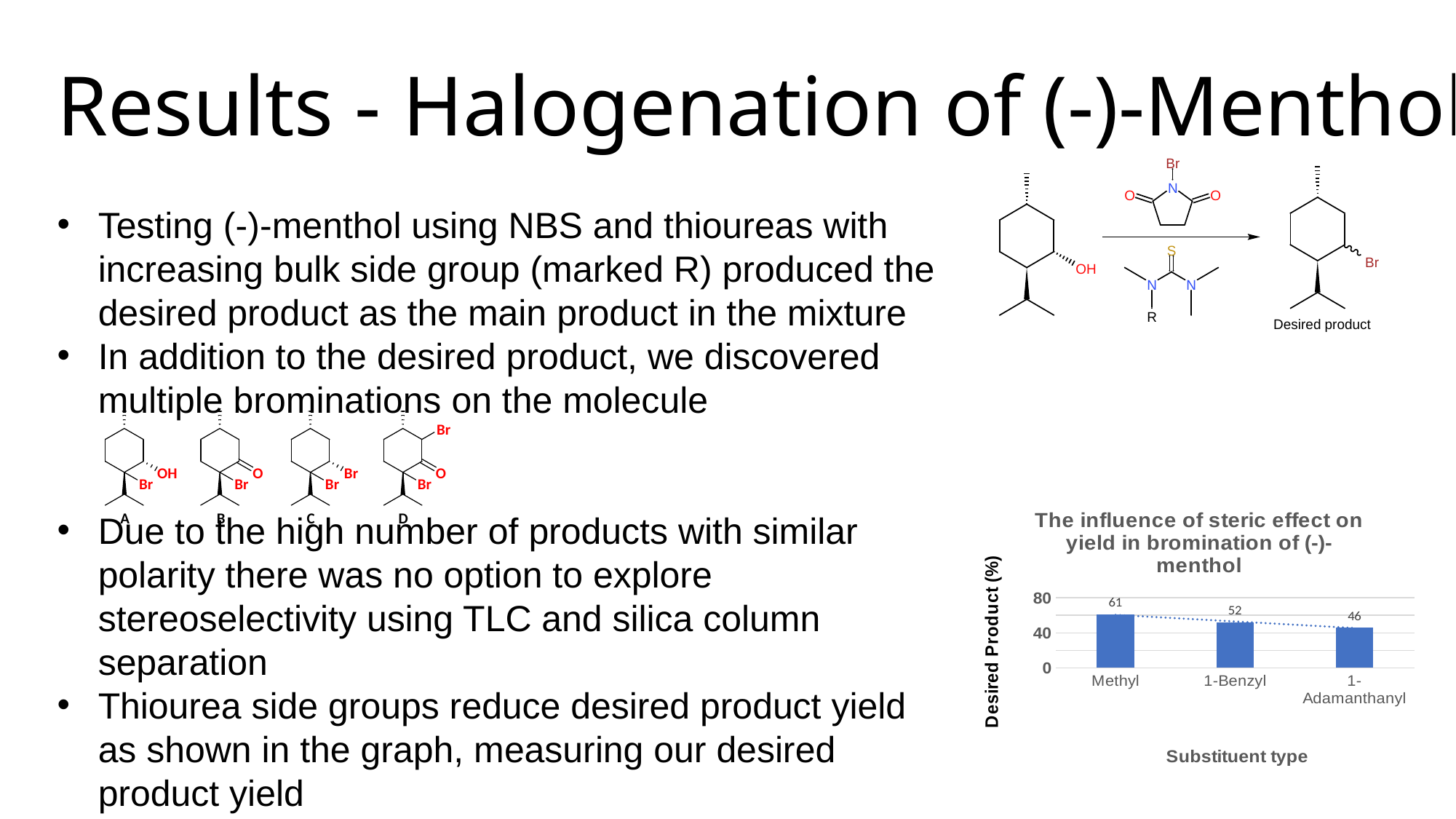
What kind of chart is shown on the slide? bar chart Which substituent type has the highest desired product yield? Methyl What is the difference in desired product yield between Methyl and 1-Adamanthanyl? 15 Which substituent type has the lowest desired product yield? 1-Adamanthanyl What is the desired product yield for Methyl? 61 How many substituent types are shown in the chart? 3 Do the desired product yields rise or fall from Methyl to 1-Adamanthanyl? fall What is the desired product yield for 1-Adamanthanyl? 46 What is the desired product yield for 1-Benzyl? 52 Which has a larger desired product yield, 1-Benzyl or 1-Adamanthanyl? 1-Benzyl What is the difference in desired product yield between Methyl and 1-Benzyl? 9 Is the value for 1-Benzyl greater or less than 40? greater